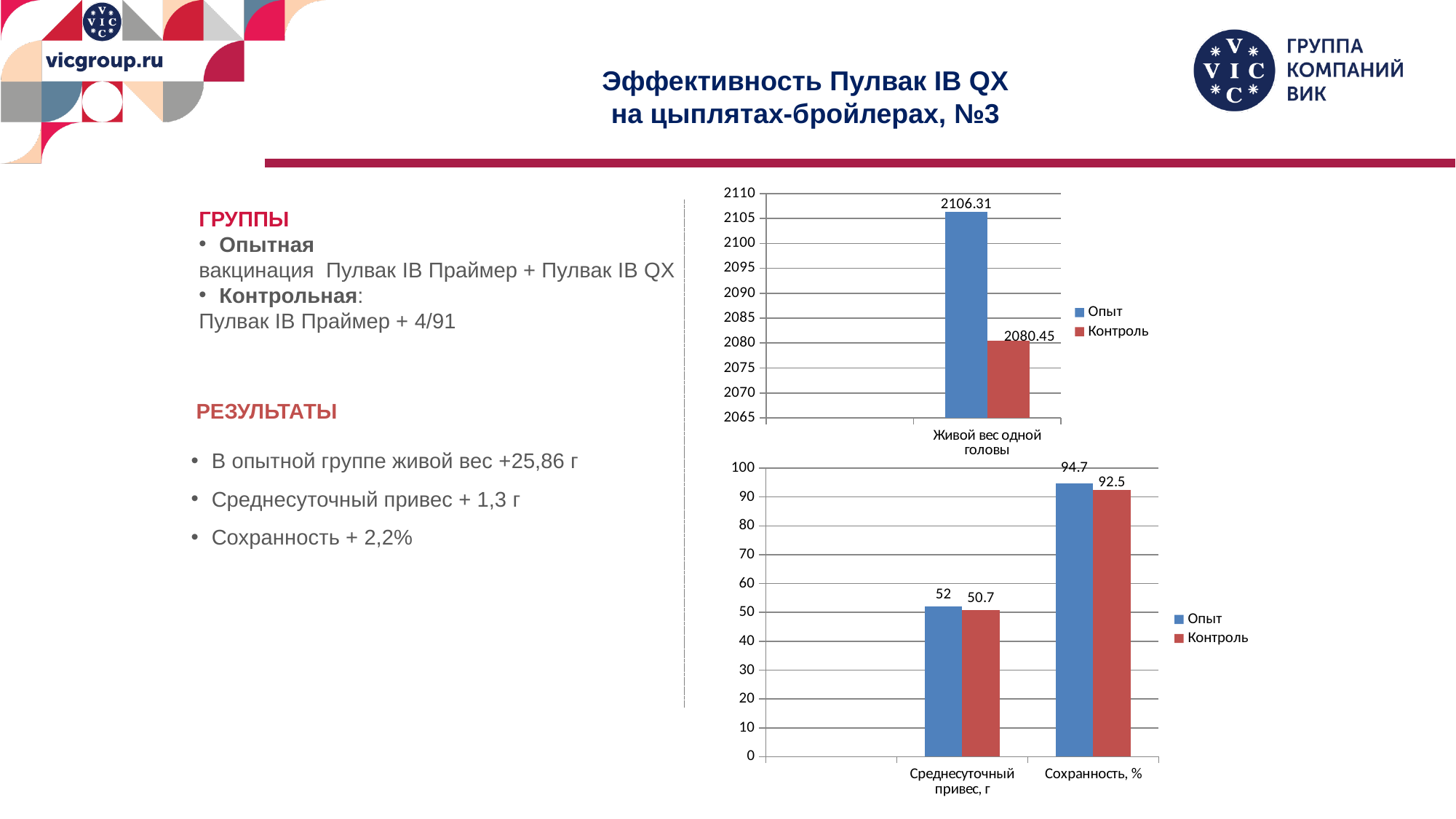
In the bottom chart, what is the value for Опыт for Сохранность, %? 94.7 In the top chart, what is the value for Опыт for Живой вес одной головы? 2106.31 What kind of chart is the top chart? Bar chart In the top chart, what is the difference between the Опыт and Контроль values for Живой вес одной головы? 25.86 In the bottom chart, what is the value for Опыт for Среднесуточный привес, г? 52 In the top chart, which series has the higher value for Живой вес одной головы, Опыт or Контроль? Опыт In the bottom chart, what is the value for Контроль for Сохранность, %? 92.5 In the bottom chart, which colour represents the Контроль series? Red In the bottom chart, what is the difference between the Опыт and Контроль values for Сохранность, %? 2.2 In the bottom chart, how many categories are shown on the x axis? 2 In the top chart, what is the value for Контроль for Живой вес одной головы? 2080.45 In the bottom chart, how many series does the legend list? 2